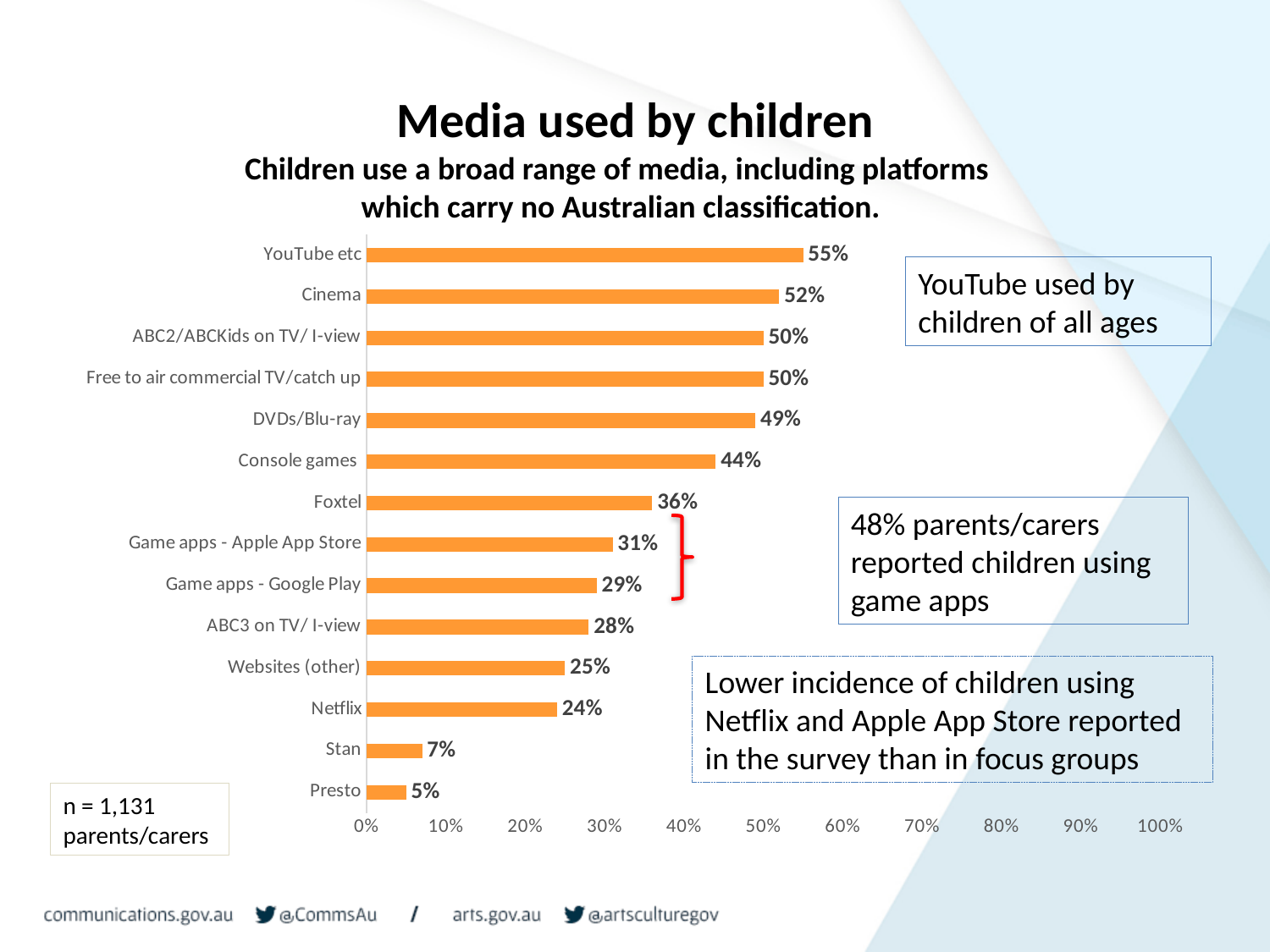
Which media category has the highest value? YouTube etc What percentage of children use YouTube etc? 55% Which is larger, the value for DVDs/Blu-ray or the value for Websites (other)? DVDs/Blu-ray Which media category has the lowest value? Presto What kind of chart is shown on the slide? bar chart What is the title of the slide? Media used by children What is the value for Netflix? 24% What is the value for Console games? 44% What is the difference between Game apps - Apple App Store and Game apps - Google Play? 2% What is the difference between the values for Cinema and Foxtel? 16% Is the value for Stan greater or less than 10%? less How many media categories are shown in the chart? 14